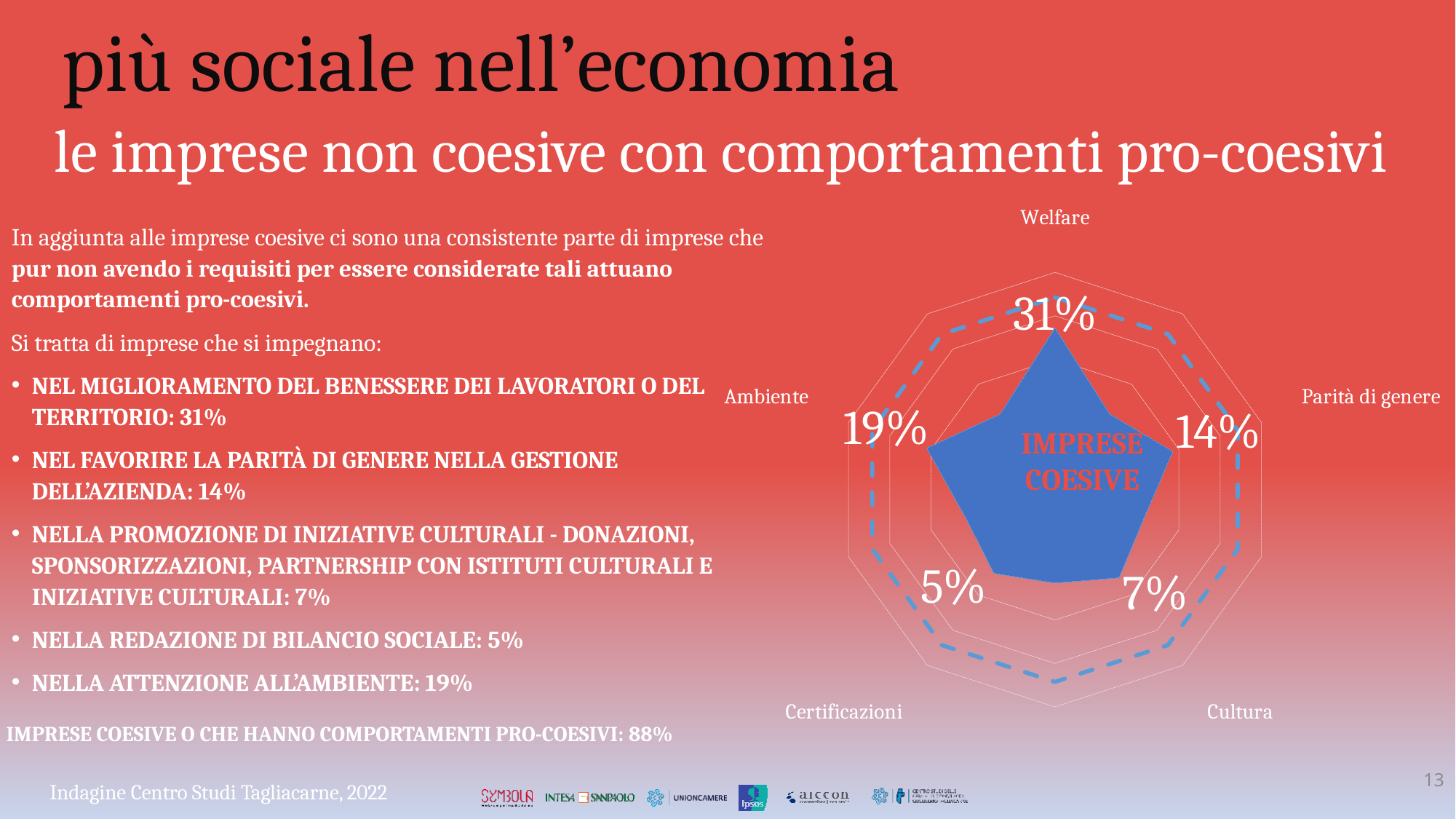
What is the value for Parità di genere on the radar chart? 14% What is the value for Welfare on the radar chart? 31% What is the value for Cultura on the radar chart? 7% What kind of chart is shown on the slide? radar chart What is the value for Certificazioni on the radar chart? 5% Which category has the highest value on the radar chart? Welfare What label is written in the centre of the radar chart's filled area? IMPRESE COESIVE How many categories (axes) does the radar chart have? 5 What is the difference between the values for Welfare and Ambiente on the radar chart? 12% What is the value for Ambiente on the radar chart? 19% Which category has the lowest value on the radar chart? Certificazioni Which is larger on the radar chart, the value for Parità di genere or the value for Cultura? Parità di genere